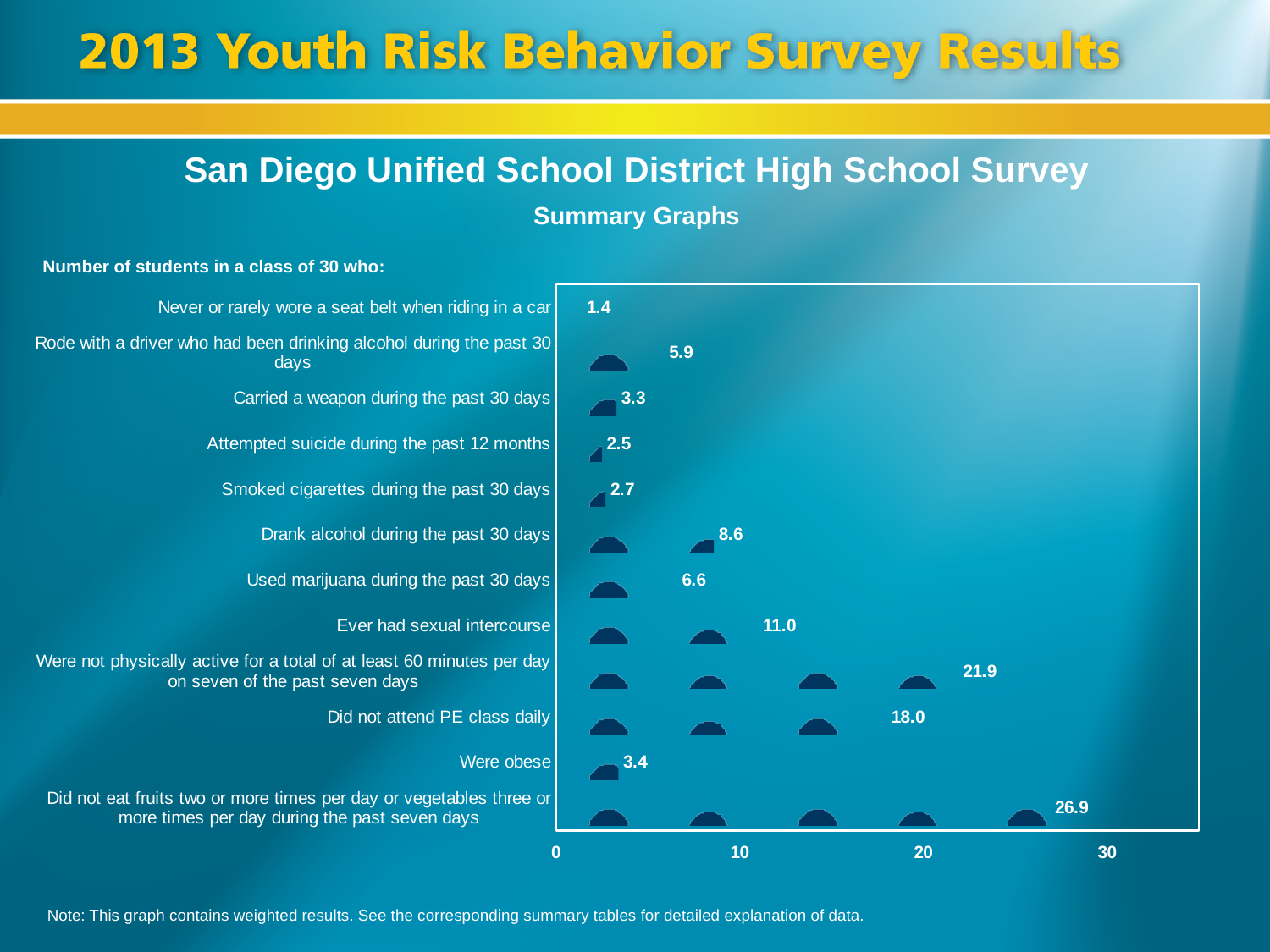
What is the value for 'Were obese'? 3.4 What is the highest tick value shown on the horizontal axis? 30 Is the value for 'Ever had sexual intercourse' greater or less than 10? greater What kind of chart is shown on the slide? bar chart Which category has the lowest value? Never or rarely wore a seat belt when riding in a car What is the difference between the values for 'Carried a weapon during the past 30 days' and 'Smoked cigarettes during the past 30 days'? 0.6 How many categories are shown in the chart? 12 Which is larger: the value for 'Used marijuana during the past 30 days' or 'Rode with a driver who had been drinking alcohol during the past 30 days'? Used marijuana during the past 30 days What is the value for 'Did not attend PE class daily'? 18.0 Which category has the highest value? Did not eat fruits two or more times per day or vegetables three or more times per day during the past seven days What is the difference between the values for 'Were not physically active for a total of at least 60 minutes per day on seven of the past seven days' and 'Did not attend PE class daily'? 3.9 What is the value for 'Drank alcohol during the past 30 days'? 8.6